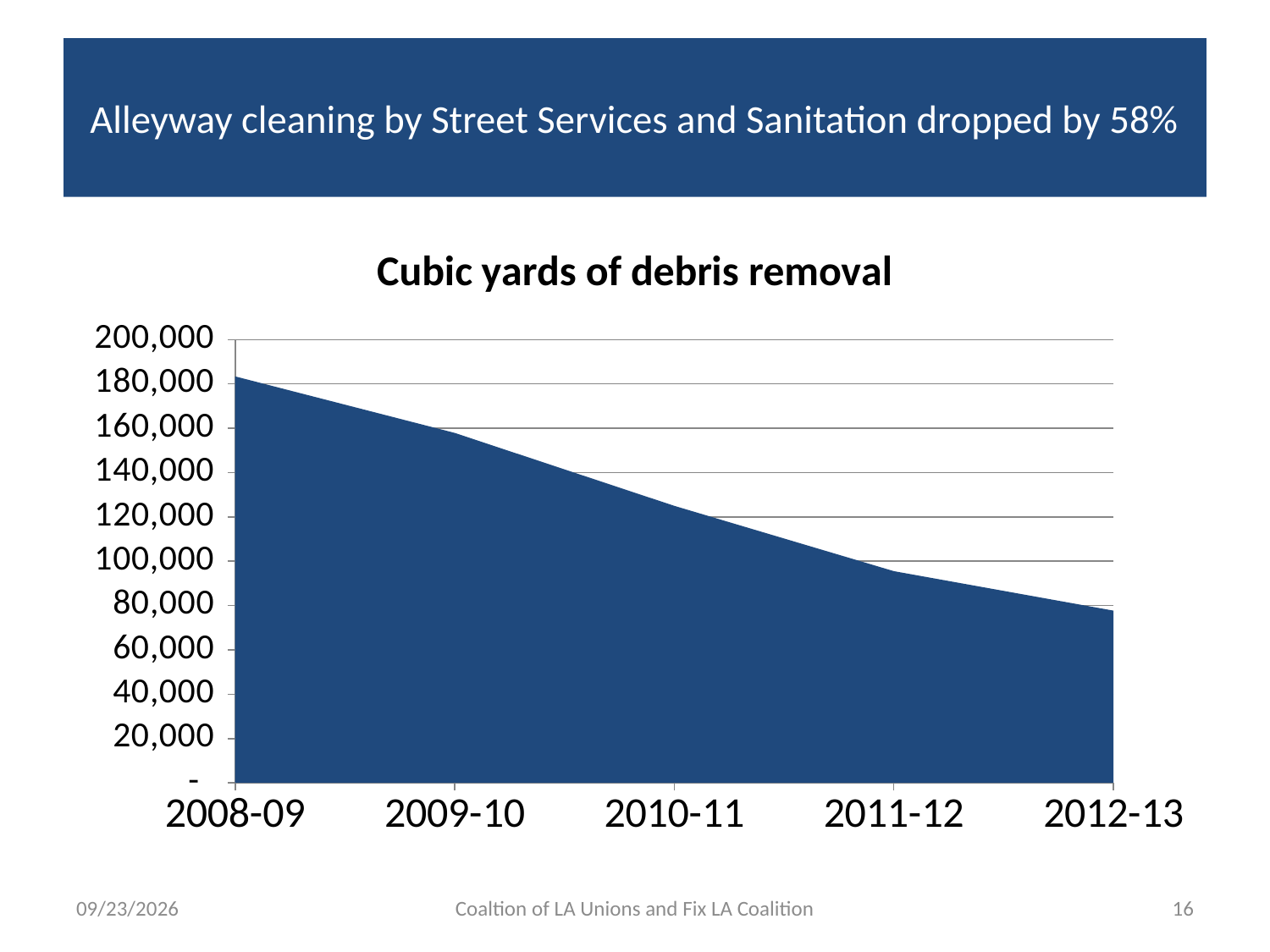
What is the title of the chart? Cubic yards of debris removal How many fiscal years are plotted along the x axis? 5 Is the value for 2009-10 greater or less than 140,000? greater What kind of chart is shown on the slide? area chart Which fiscal year has the lowest value? 2012-13 Which is larger, the value for 2009-10 or the value for 2011-12? 2009-10 Do the values rise or fall from 2008-09 to 2012-13? fall Is the value for 2011-12 greater or less than 100,000? less Is the value for 2012-13 greater or less than 60,000? greater Which fiscal year has the highest value? 2008-09